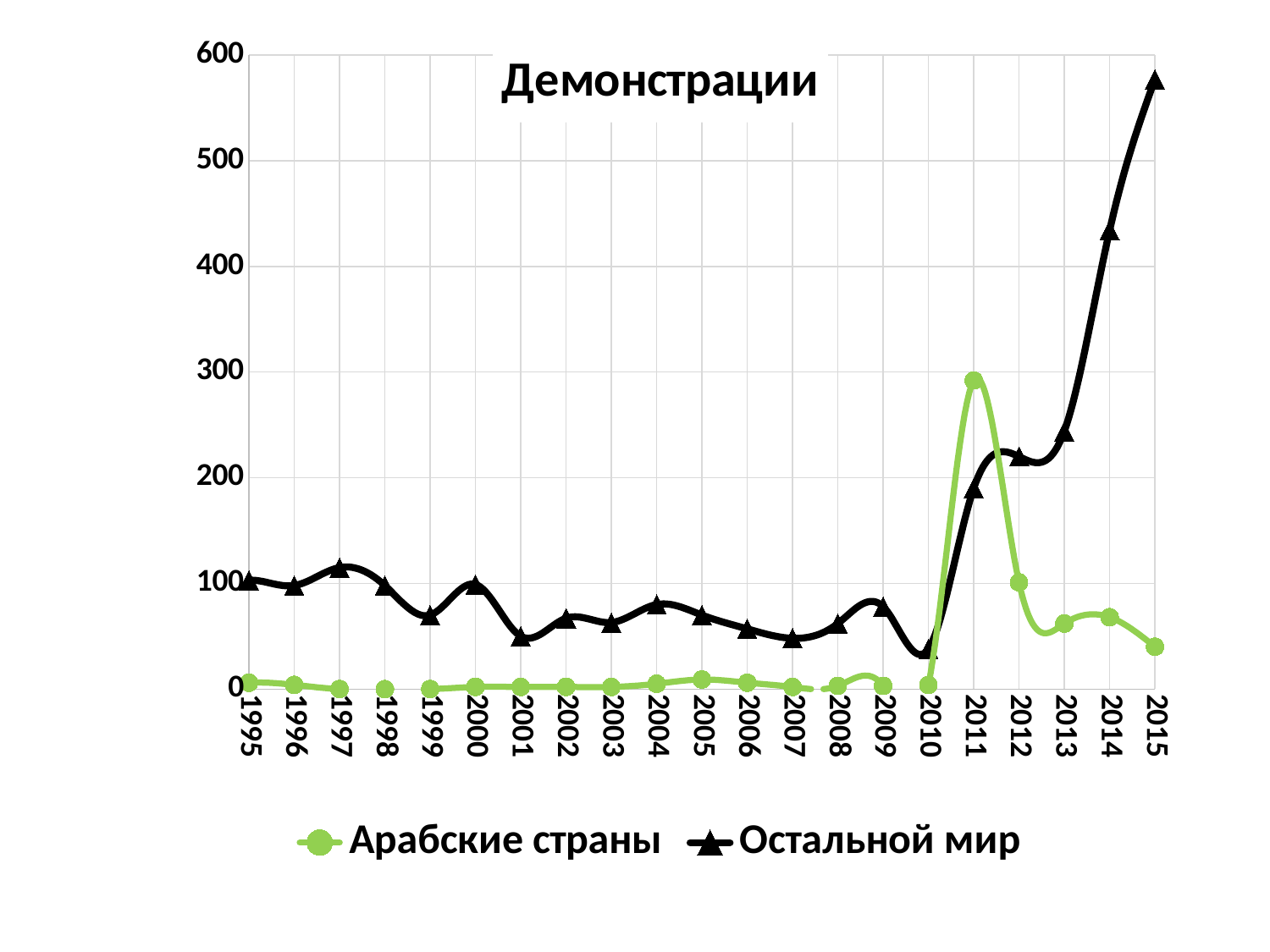
Is the value for 'Остальной мир' in 2014 greater or less than 400? greater In 2011, which series has the higher value, 'Арабские страны' or 'Остальной мир'? Арабские страны How many years are shown on the x axis? 21 What is the title of the chart? Демонстрации In which year does the series 'Арабские страны' reach its highest value? 2011 Is the value for 'Арабские страны' in 2011 greater or less than 200? greater Does the series 'Остальной мир' rise or fall from 2010 to 2015? Rise Is the value for 'Остальной мир' in 2010 greater or less than 100? less In which year does the series 'Остальной мир' reach its highest value? 2015 How many series does the legend list? 2 What kind of chart is shown on the slide? Line chart